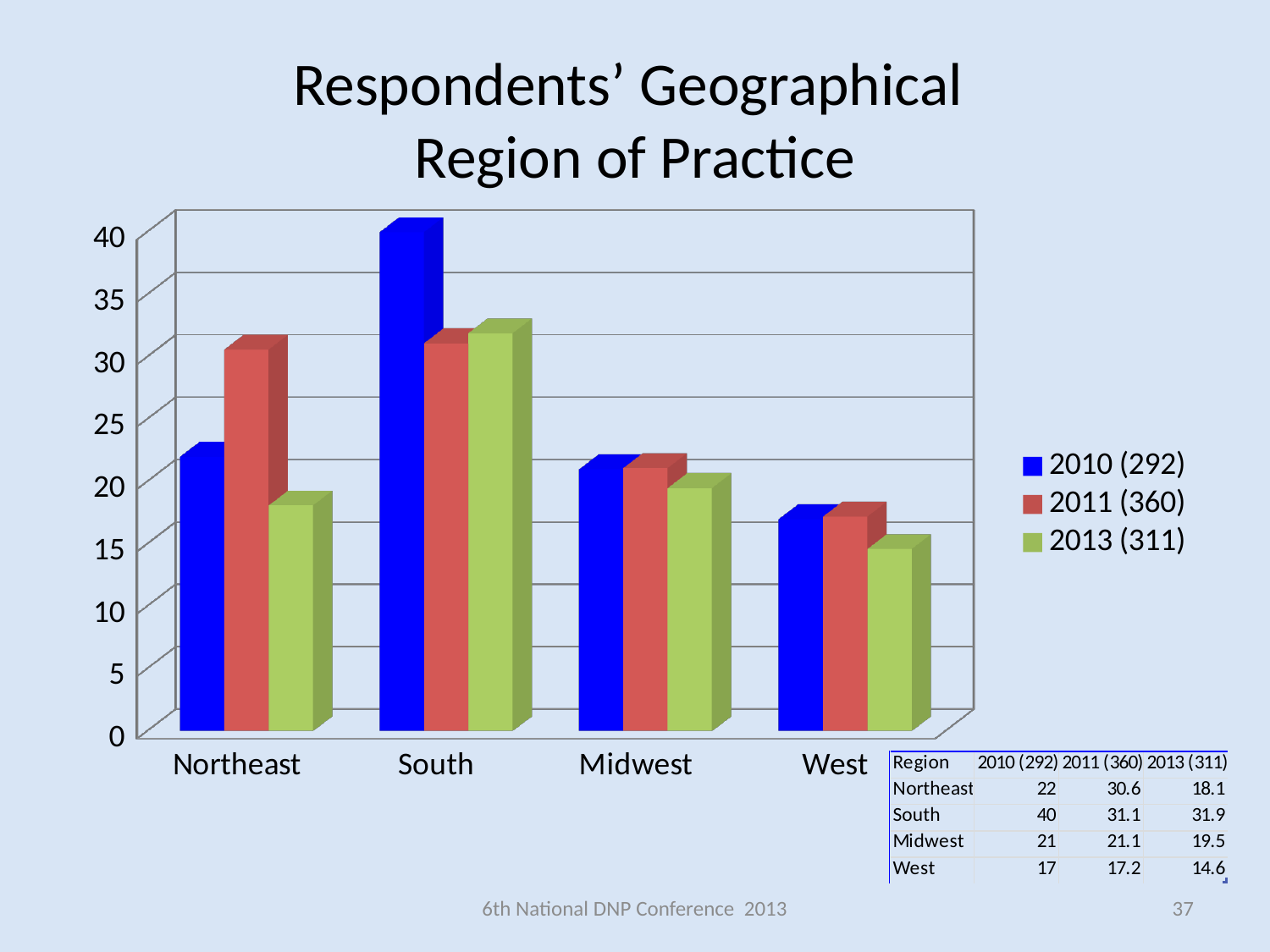
Which region has the highest value in the 2010 (292) series? South What is the title of the chart? Respondents' Geographical Region of Practice Is the value for South in the 2011 (360) series greater or less than 35? less What is the value for West in the 2013 (311) series? 14.6 Which region has the lowest value in the 2013 (311) series? West What is the difference between the 2010 (292) and 2013 (311) values for Northeast? 3.9 How many regions are shown on the x axis? 4 Which is larger for Midwest: the 2011 (360) value or the 2013 (311) value? 2011 (360) What kind of chart is shown on the slide? bar chart How many series does the legend list? 3 What is the value for Northeast in the 2011 (360) series? 30.6 What is the value for South in the 2010 (292) series? 40